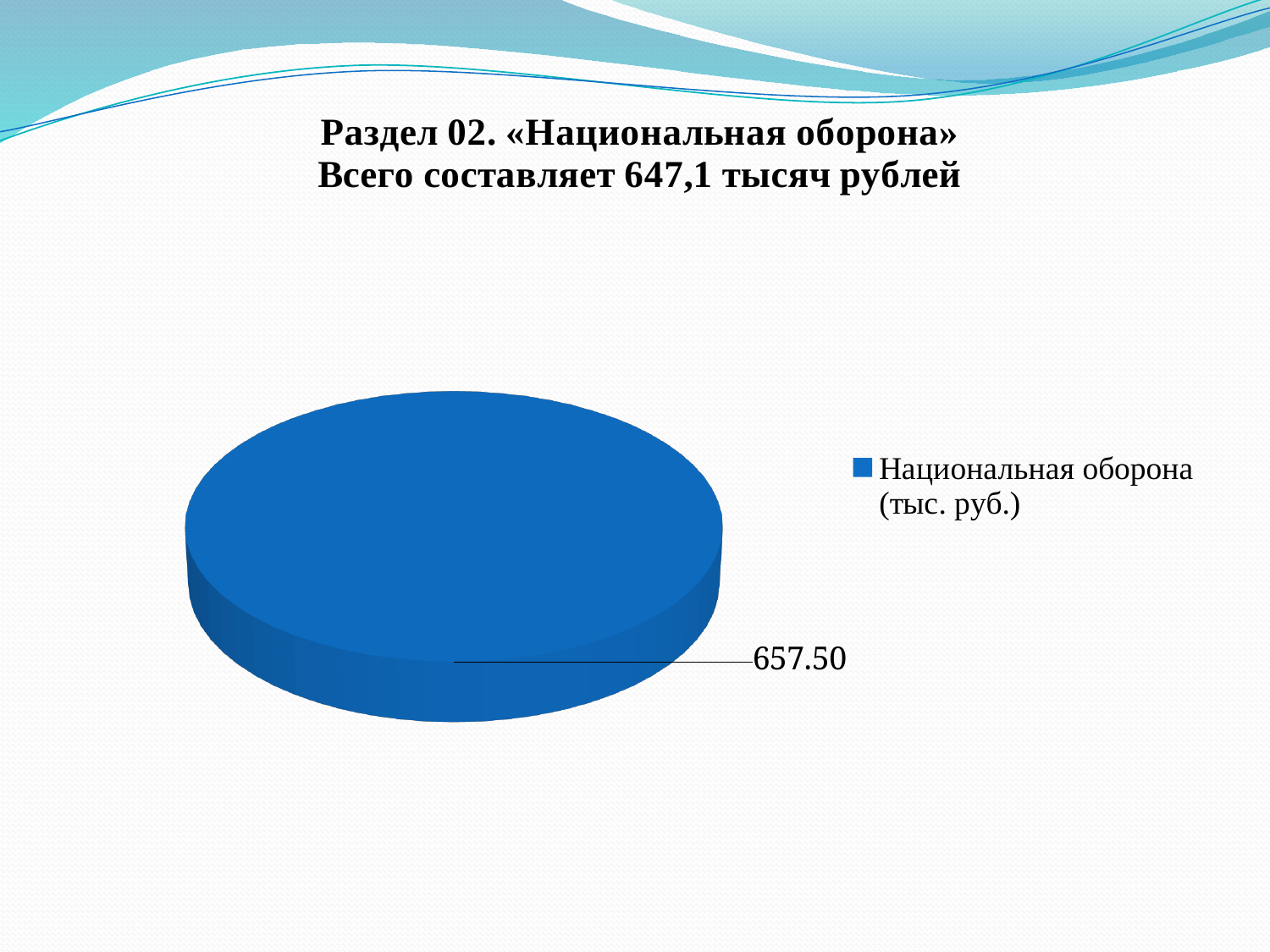
What share of the pie does the Национальная оборона (тыс. руб.) slice represent? 100% What colour is the single slice of the pie chart? blue What is the legend entry shown next to the pie chart? Национальная оборона (тыс. руб.) What value is printed as the data label on the pie chart? 657.50 How many entries does the legend of the pie chart list? 1 What kind of chart is shown on the slide? pie chart What is the value for Национальная оборона (тыс. руб.) in the pie chart? 657.50 How many slices does the pie chart have? 1